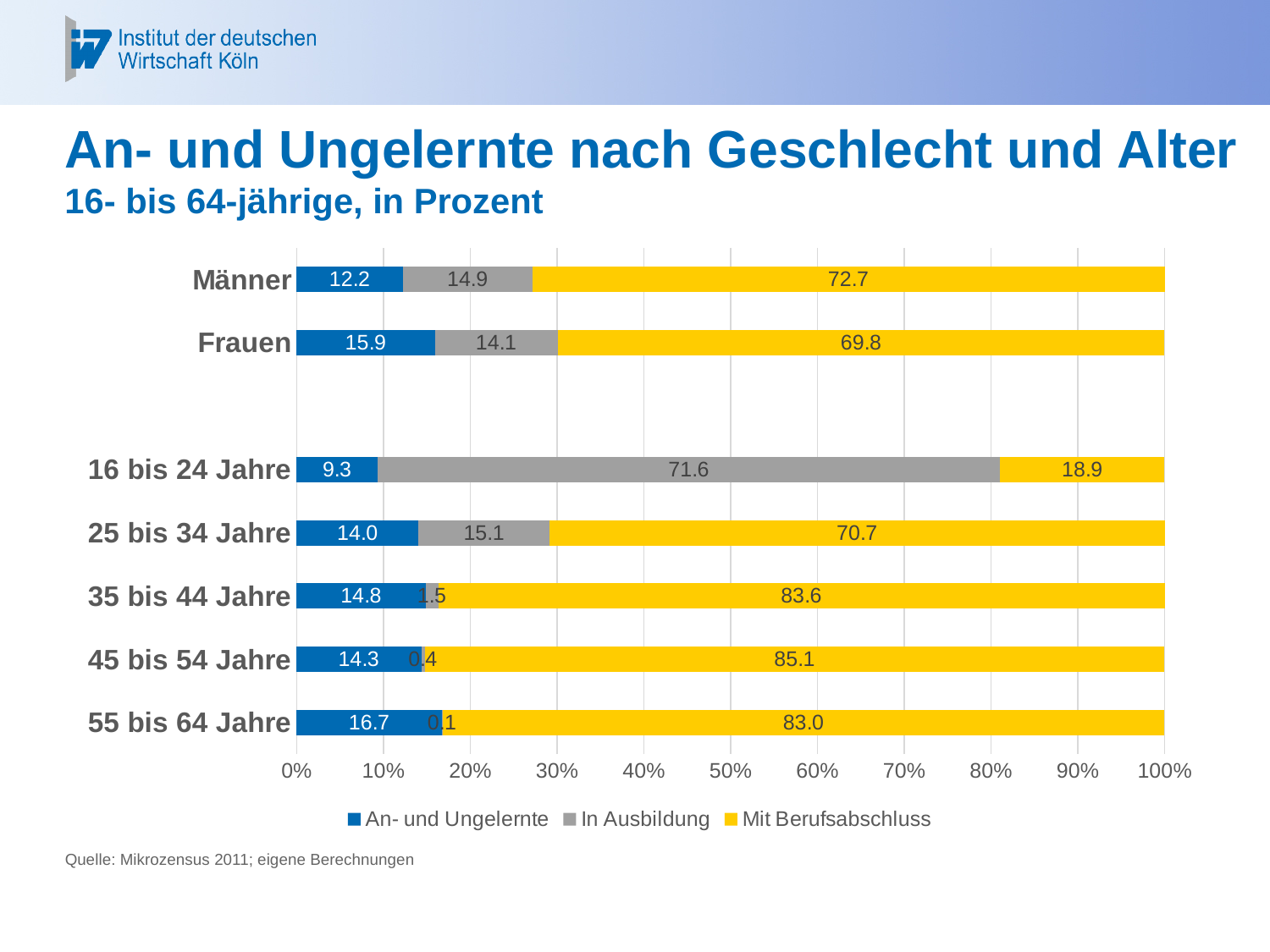
Which is larger, the Mit Berufsabschluss value for 25 bis 34 Jahre or for 35 bis 44 Jahre? 35 bis 44 Jahre What kind of chart is shown on the slide? Stacked bar chart Which category has the highest value for Mit Berufsabschluss? 45 bis 54 Jahre How many series does the legend list? 3 What is the value of An- und Ungelernte for Frauen? 15.9 What is the title of the chart? An- und Ungelernte nach Geschlecht und Alter Is the Mit Berufsabschluss value for 16 bis 24 Jahre greater or less than 20%? less What is the value of Mit Berufsabschluss for Männer? 72.7 What is the difference between the An- und Ungelernte values for Frauen and Männer? 3.7 What is the value of In Ausbildung for 16 bis 24 Jahre? 71.6 Which category has the lowest value for An- und Ungelernte? 16 bis 24 Jahre How many categories are shown on the vertical axis? 7